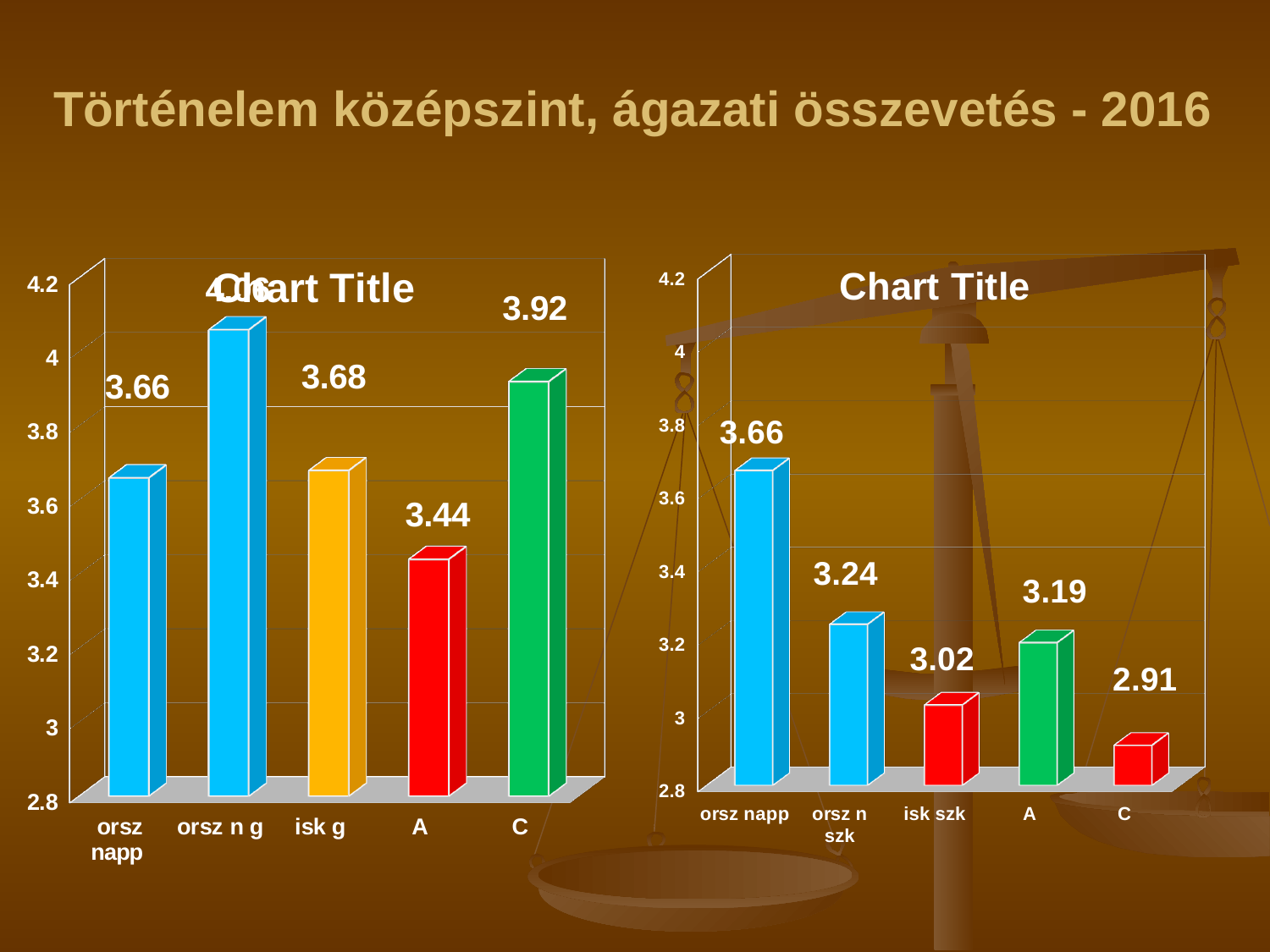
In the right chart, which is larger, the value for orsz n szk or the value for A? orsz n szk In the right chart, what is the value for C? 2.91 In the right chart, which category has the lowest value? C In the right chart, what is the value for isk szk? 3.02 In the left chart, what is the difference between the values for C and A? 0.48 How many categories does the right chart show? 5 In the left chart, what is the value for A? 3.44 In the left chart, which category has the highest value? orsz n g In the right chart, what is the difference between the values for orsz napp and orsz n szk? 0.42 In the left chart, which category has the lowest value? A In the left chart, is the value for orsz n g greater or less than 4? greater In the left chart, what is the value for isk g? 3.68